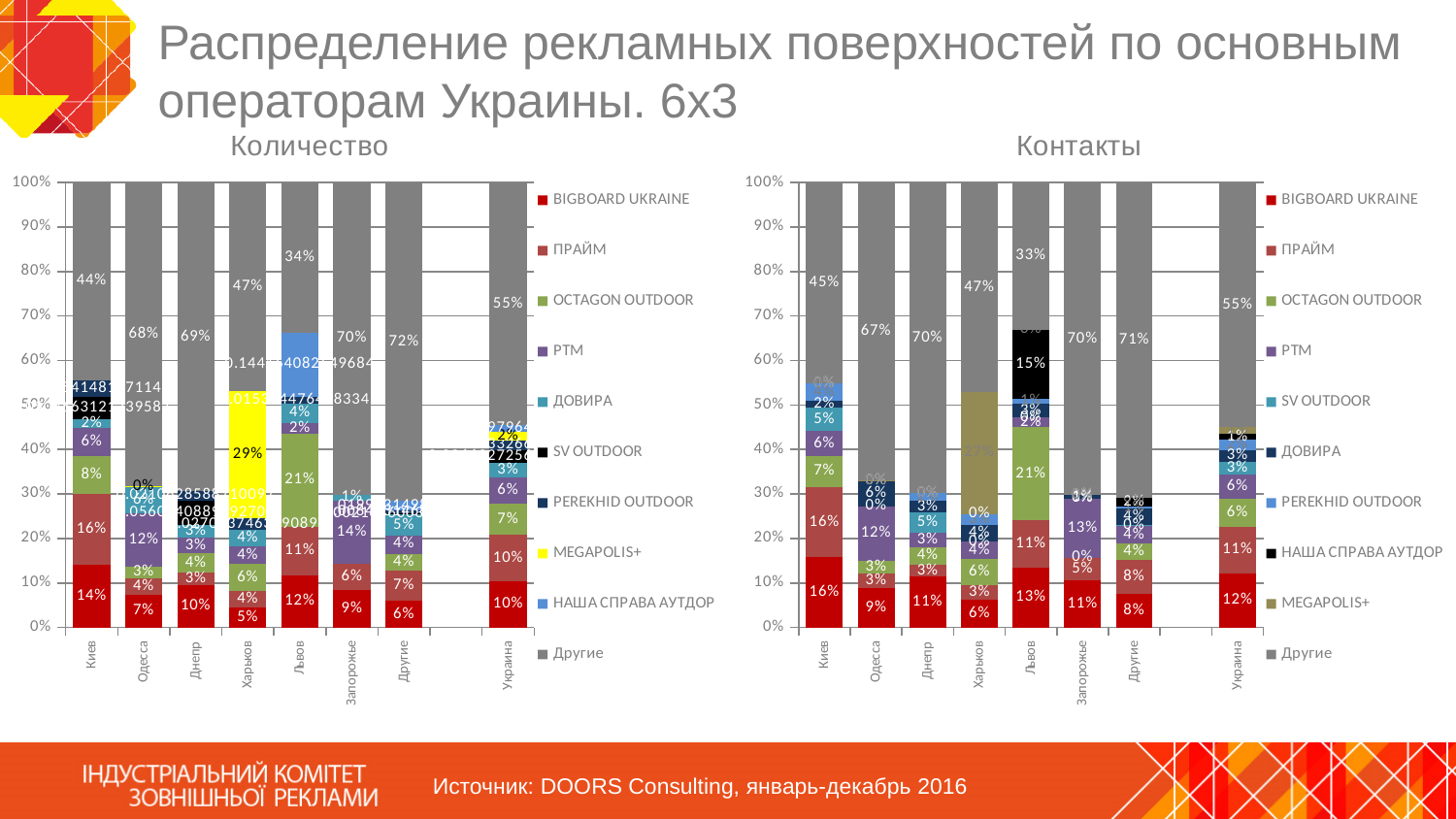
In the "Количество" chart, what is the value of the MEGAPOLIS+ segment for Харьков? 29% In the "Количество" chart, which category has the smallest "Другие" segment? Львов In the "Контакты" chart, which is larger: the BIGBOARD UKRAINE segment for Киев or for Одесса? Киев In the "Количество" chart, which category has the largest "Другие" segment? Другие How many series does the legend of the "Количество" chart list? 10 In the "Количество" chart, what is the value of the BIGBOARD UKRAINE segment for Львов? 12% In the "Количество" chart, what is the value of the "Другие" segment for Киев? 44% In the "Контакты" chart, what is the difference between the "Другие" segment for Днепр and for Киев? 25% How many categories are shown on the x axis of the "Контакты" chart? 8 What kind of chart is the "Количество" chart on the left? stacked bar chart In the "Контакты" chart, what is the value of the BIGBOARD UKRAINE segment for Украина? 12% In the "Контакты" chart, what is the value of the "Другие" segment for Львов? 33%